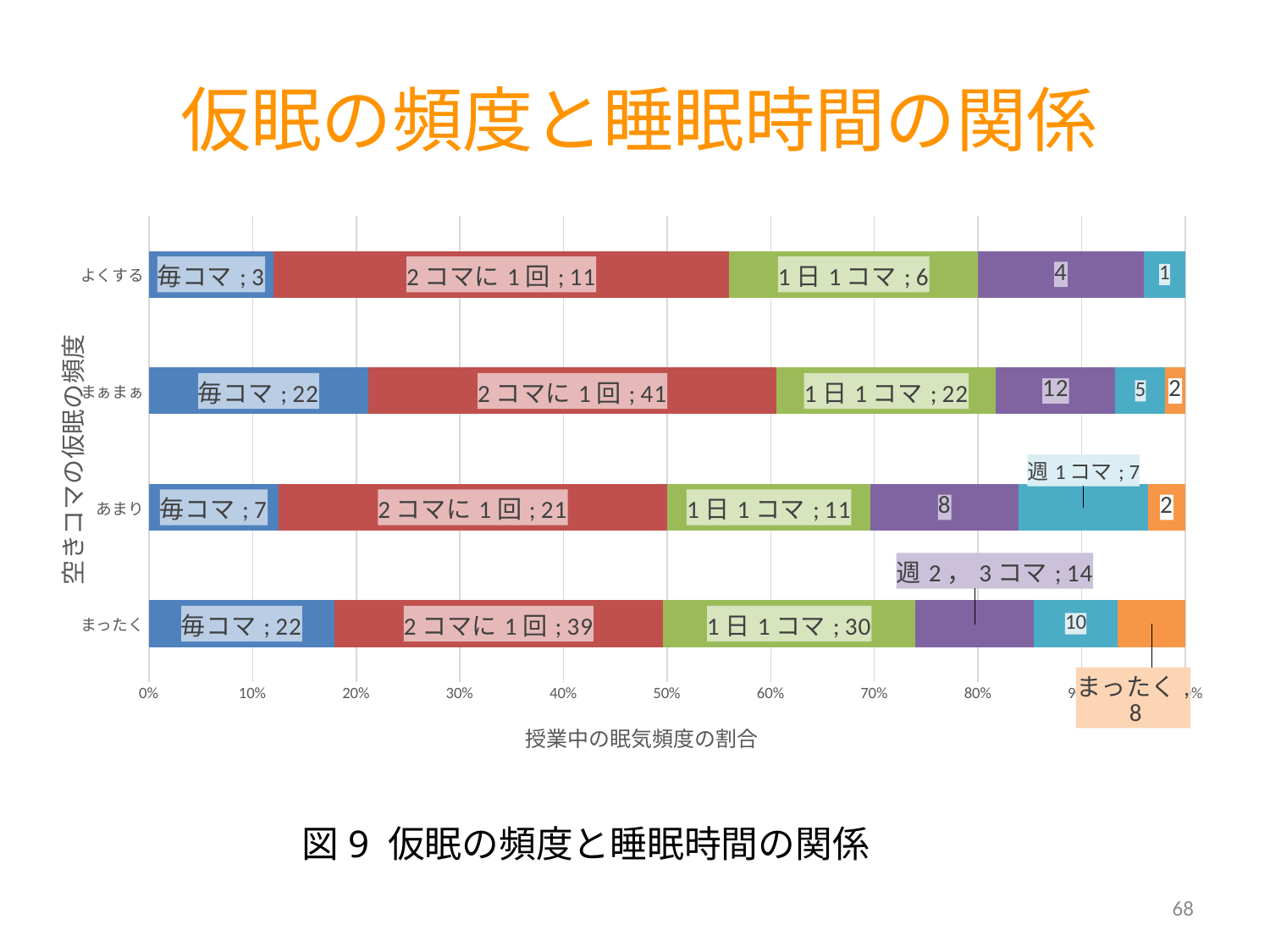
What is the value of 2コマに1回 for the まったく category? 39 What is the value of 1日1コマ for the あまり category? 11 What is the title of the horizontal axis of the chart? 授業中の眠気頻度の割合 Which category has the highest 2コマに1回 value? まぁまぁ What is the value of 毎コマ for the まぁまぁ category? 22 How many categories are shown on the vertical axis of the chart? 4 What is the total of all segments in the よくする bar? 25 What kind of chart is shown on the slide? bar chart Which is larger: the 1日1コマ value for まったく or for まぁまぁ? まったく What is the value of 週2，3コマ for the まったく category? 14 What is the difference between the 2コマに1回 values for まぁまぁ and あまり? 20 What is the value of 週1コマ for the あまり category? 7